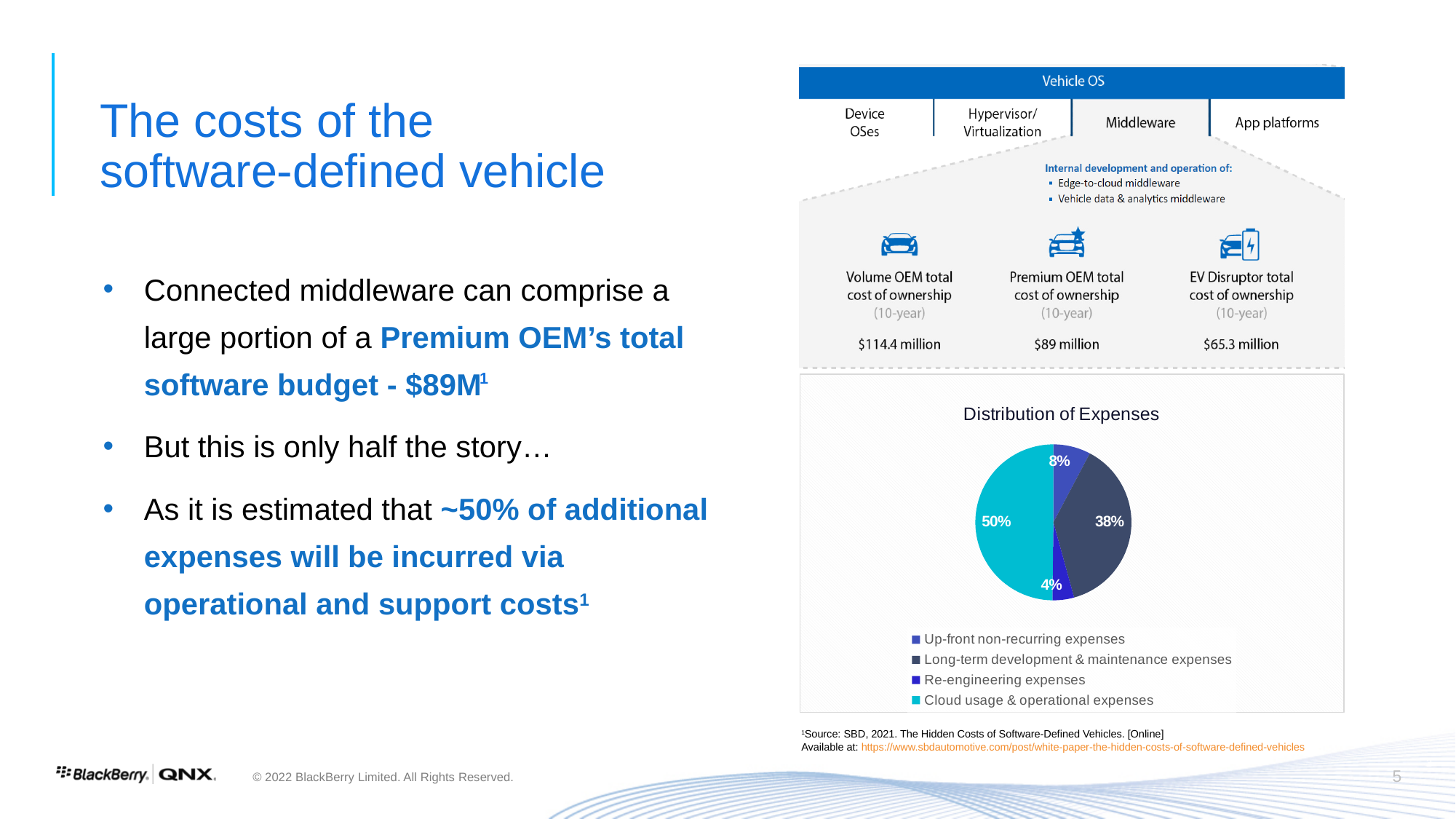
How many entries does the legend of the "Distribution of Expenses" pie chart list? 4 What kind of chart is the "Distribution of Expenses" chart? pie chart In the "Distribution of Expenses" pie chart, which category has the largest share? Cloud usage & operational expenses In the "Distribution of Expenses" pie chart, which is larger: Up-front non-recurring expenses or Re-engineering expenses? Up-front non-recurring expenses In the "Distribution of Expenses" pie chart, what share is Long-term development & maintenance expenses? 38% In the "Distribution of Expenses" pie chart, which category has the smallest share? Re-engineering expenses How many slices does the "Distribution of Expenses" pie chart have? 4 In the "Distribution of Expenses" pie chart, what share is Up-front non-recurring expenses? 8% What is the title of the pie chart on the slide? Distribution of Expenses In the "Distribution of Expenses" pie chart, what share is Cloud usage & operational expenses? 50% In the "Distribution of Expenses" pie chart, what is the difference in percentage points between Cloud usage & operational expenses and Long-term development & maintenance expenses? 12 percentage points